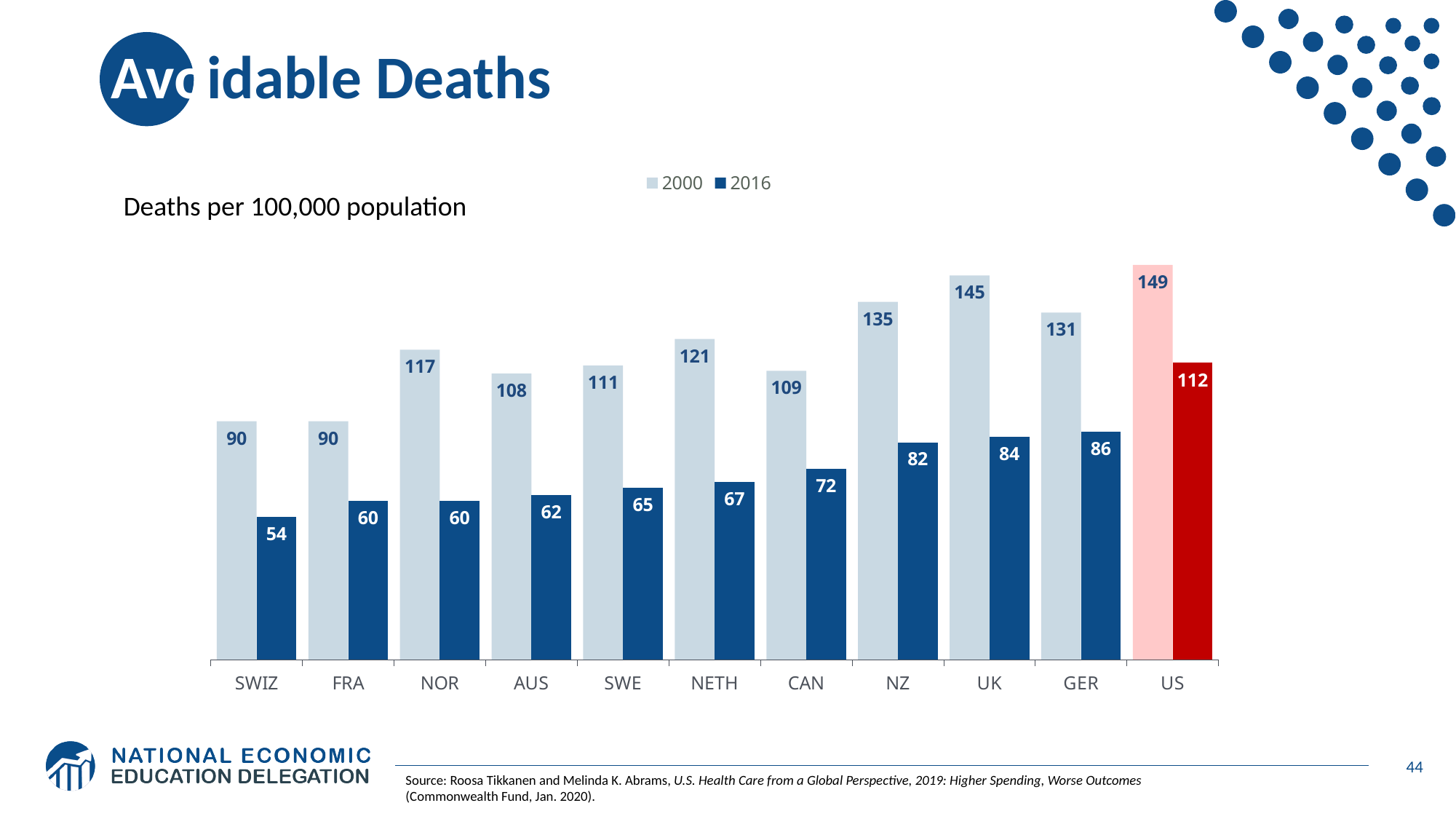
How many series does the legend list? 2 What is the difference between the 2000 values for UK and SWIZ? 55 What unit is the chart measured in, according to the text on the slide? Deaths per 100,000 population What was the value for SWIZ in 2016? 54 Which country had the highest value in 2016? US Which is larger, the 2016 value for UK or the 2016 value for GER? GER How many countries are shown on the x axis? 11 What is the difference between the 2000 and 2016 values for the US? 37 What was the value for the US in 2000? 149 Which country had the lowest value in 2016? SWIZ What was the value for NETH in 2000? 121 What kind of chart is shown on the slide? Bar chart